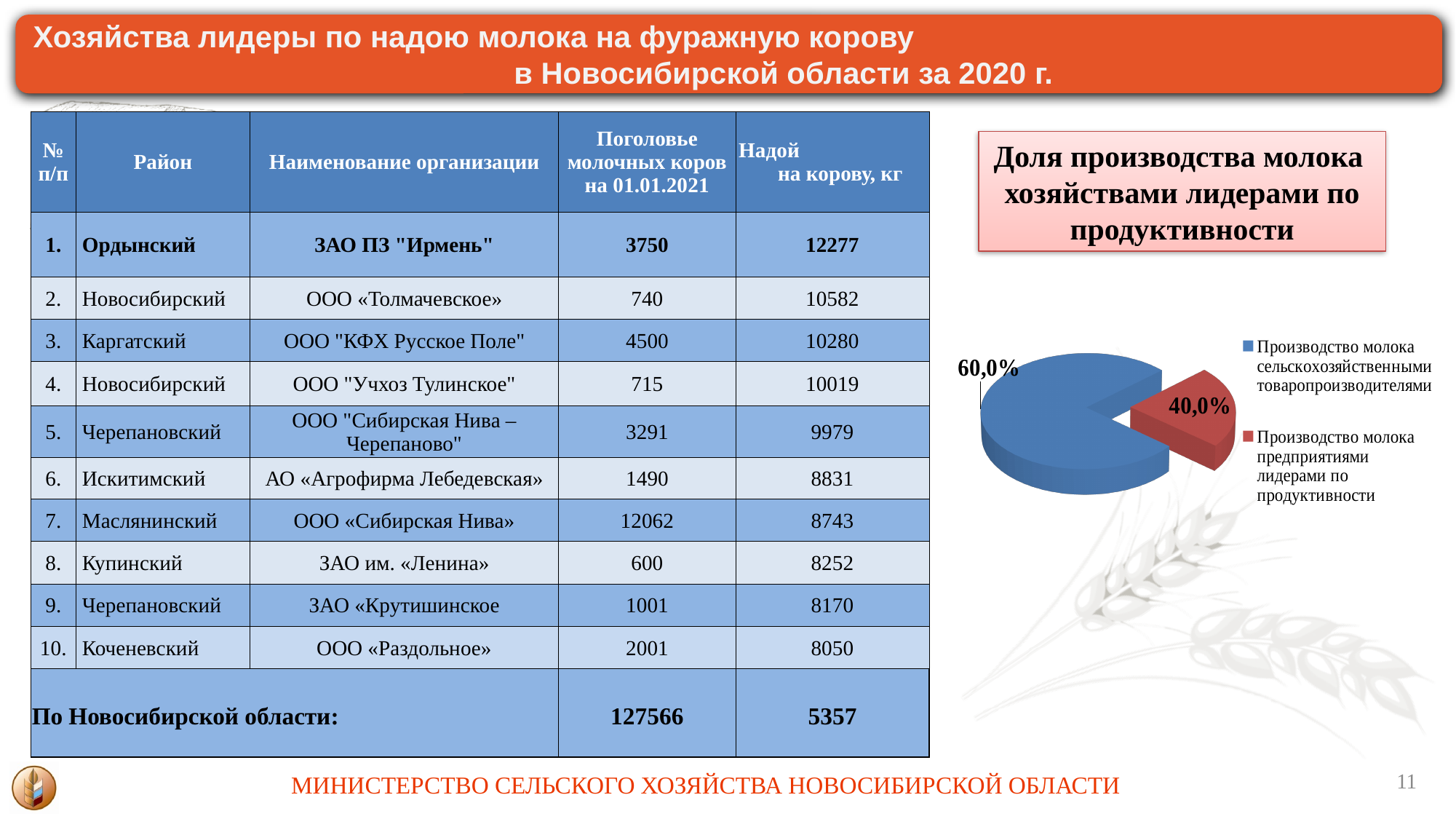
What colour is the slice labelled 40,0% in the pie chart? red How many slices does the pie chart have? 2 How many entries does the legend of the pie chart list? 2 Is the share for "Производство молока предприятиями лидерами по продуктивности" greater or less than 50%? less Which slice of the pie chart is the largest? Производство молока сельскохозяйственными товаропроизводителями What is the title shown above the pie chart? Доля производства молока хозяйствами лидерами по продуктивности What share of the pie chart is labelled "Производство молока сельскохозяйственными товаропроизводителями"? 60,0% Which slice of the pie chart is the smallest? Производство молока предприятиями лидерами по продуктивности What kind of chart is shown on the slide? pie chart What is the difference in percentage points between the two slices of the pie chart? 20,0% Which is larger in the pie chart: the share for "Производство молока сельскохозяйственными товаропроизводителями" or the share for "Производство молока предприятиями лидерами по продуктивности"? Производство молока сельскохозяйственными товаропроизводителями What share of the pie chart is labelled "Производство молока предприятиями лидерами по продуктивности"? 40,0%